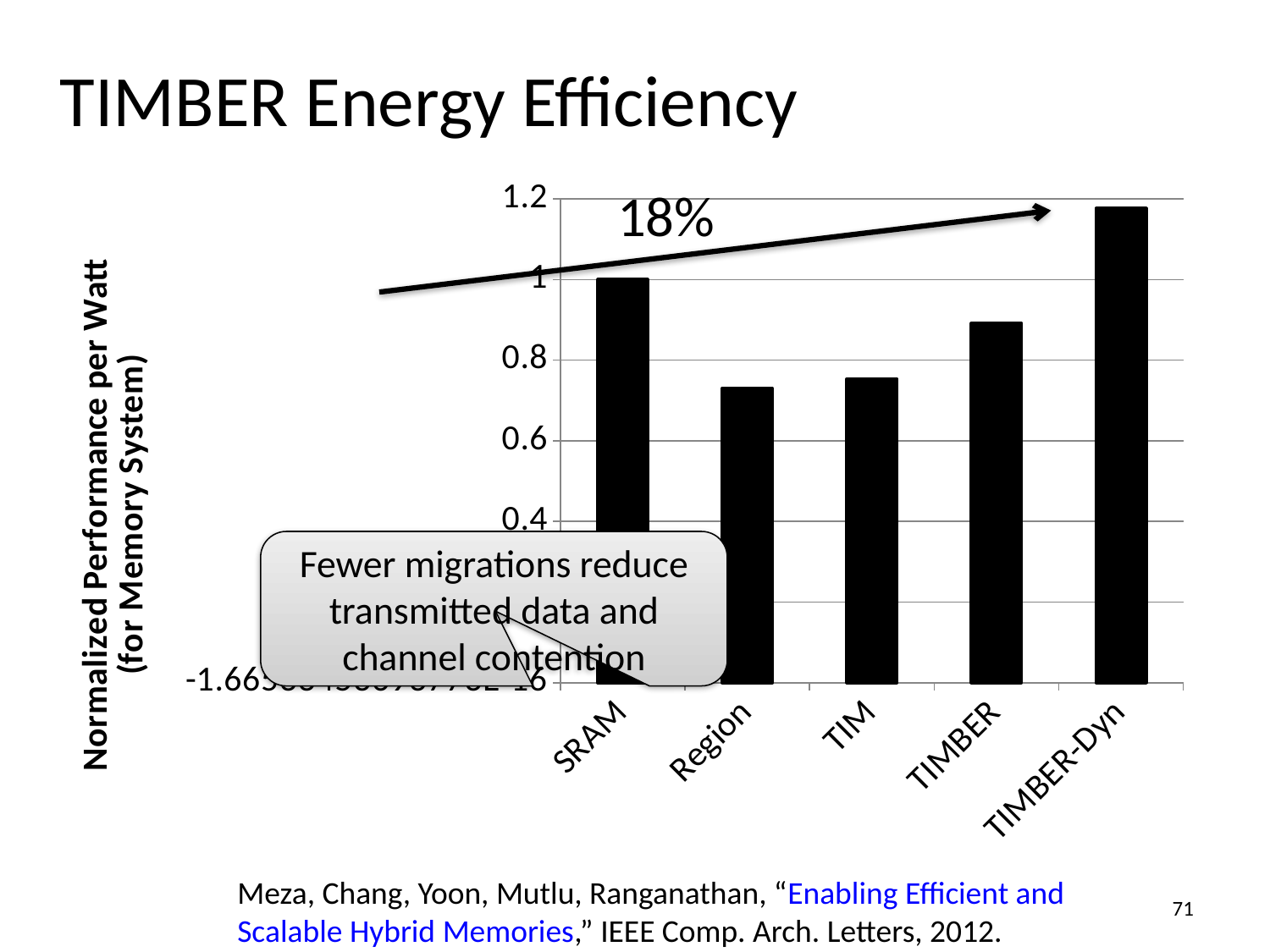
What is the normalized performance per watt for SRAM? 1 What percentage is written next to the arrow annotation on the chart? 18% Is the value for TIMBER greater or less than 1? less Is the value for TIMBER-Dyn greater or less than 1? greater What kind of chart is shown on the slide? bar chart How many categories are plotted on the x axis of the chart? 5 Is the value for TIM greater or less than 0.8? less Which category has the highest normalized performance per watt? TIMBER-Dyn Which has a higher normalized performance per watt, TIMBER or TIM? TIMBER What is the label of the y axis of the chart? Normalized Performance per Watt (for Memory System)